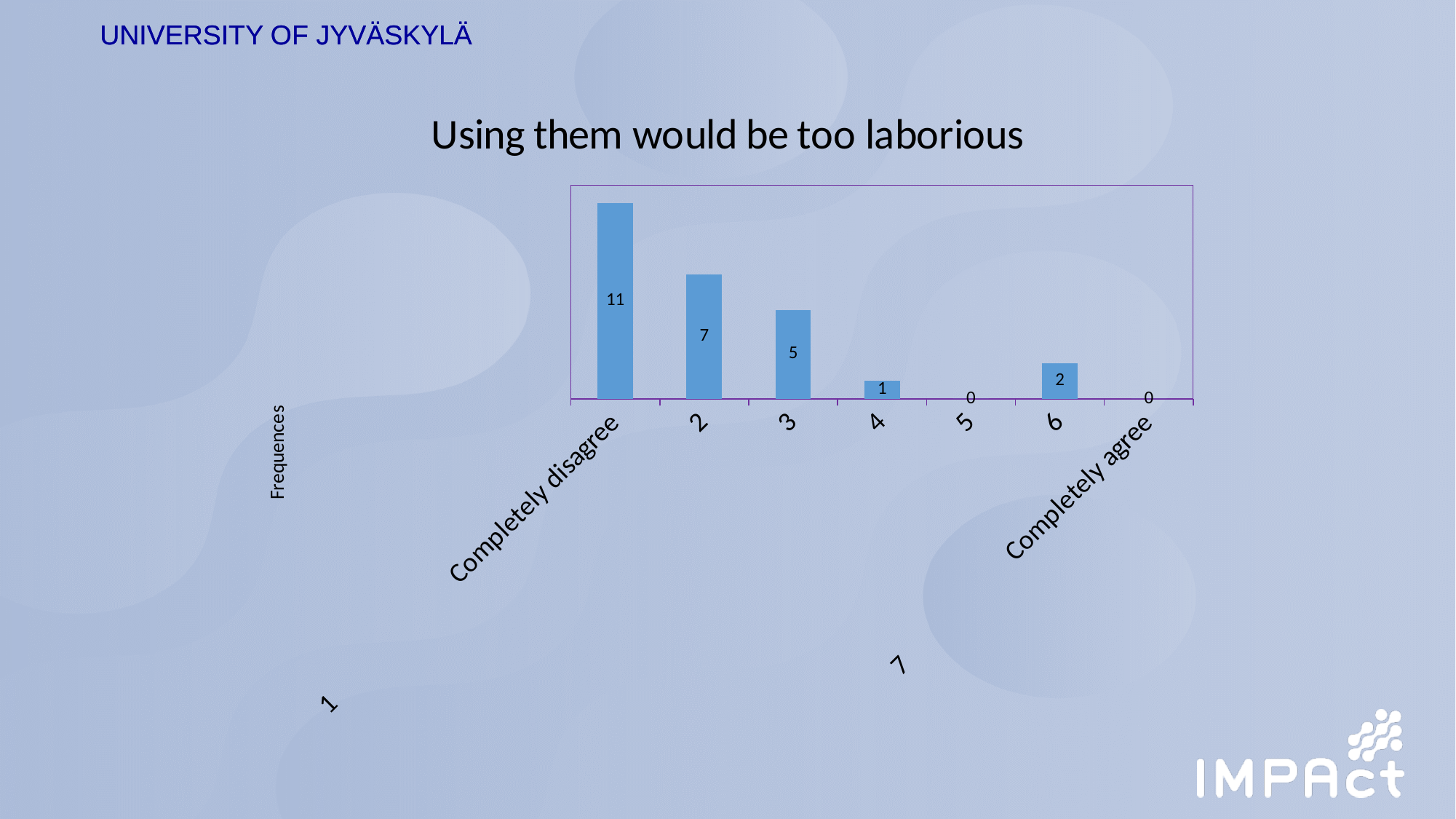
What is the value for category 3? 5 How many categories are shown on the x axis? 7 What is the value for the "Completely agree" category? 0 What is the value for category 6? 2 What kind of chart is shown on the slide? bar chart What is the difference between the values for category 3 and category 4? 4 What is the difference between the values for "Completely disagree" and category 2? 4 What is the value for the "Completely disagree" category? 11 Which category has the highest value? Completely disagree What is the label of the vertical axis? Frequences Which is larger, the value for category 4 or the value for category 6? category 6 What is the title of the chart? Using them would be too laborious